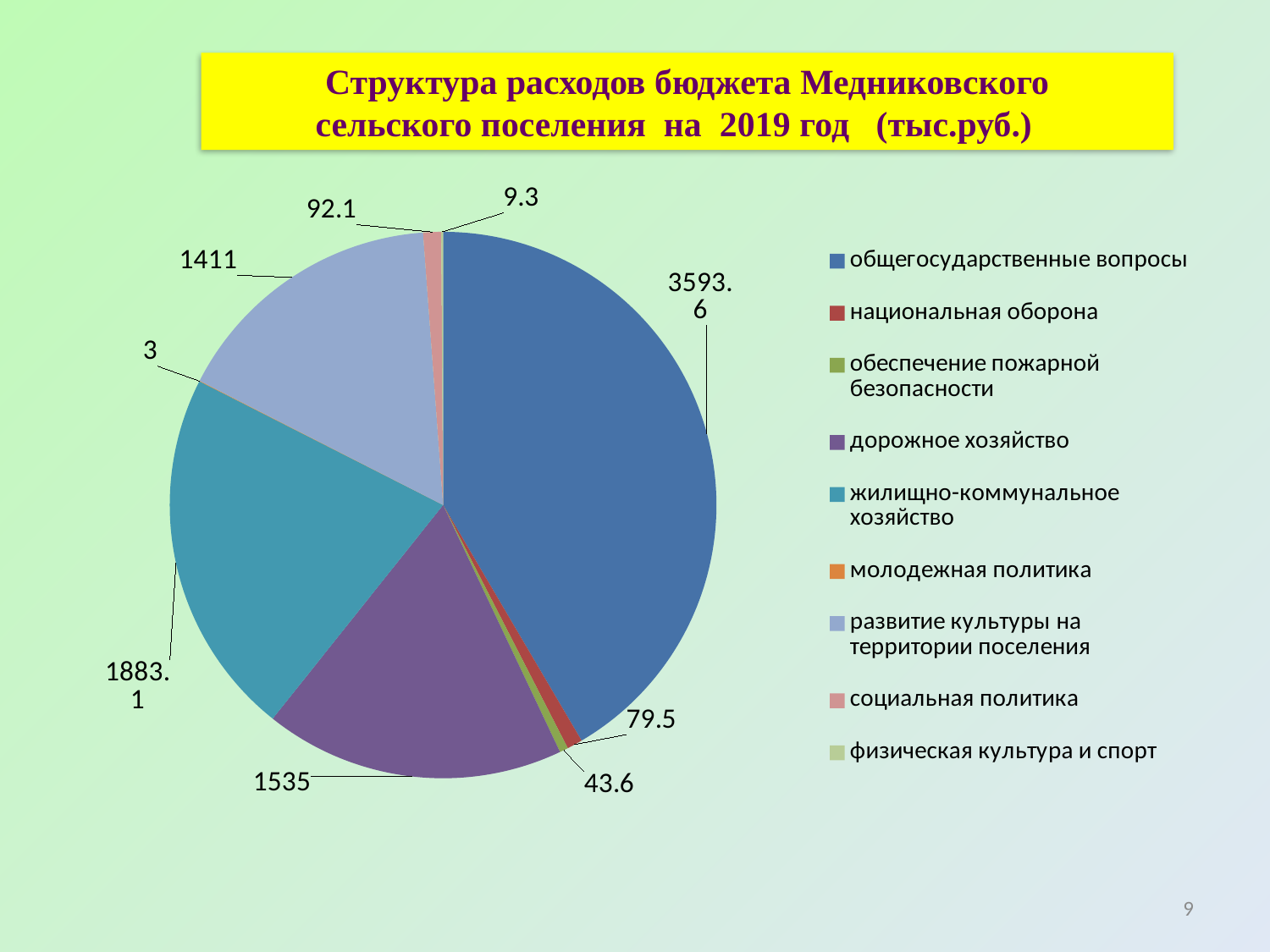
What is the value for общегосударственные вопросы? 3593.6 How many slices does the pie chart have? 9 What unit is stated in the chart title? тыс.руб. How many entries does the legend list? 9 Which is larger: дорожное хозяйство or развитие культуры на территории поселения? дорожное хозяйство What kind of chart is shown on the slide? Pie chart What is the value for дорожное хозяйство? 1535 Which category has the largest slice? общегосударственные вопросы What is the difference between the values for жилищно-коммунальное хозяйство and дорожное хозяйство? 348.1 What is the value for жилищно-коммунальное хозяйство? 1883.1 Which category has the smallest value? молодежная политика What is the value for социальная политика? 92.1